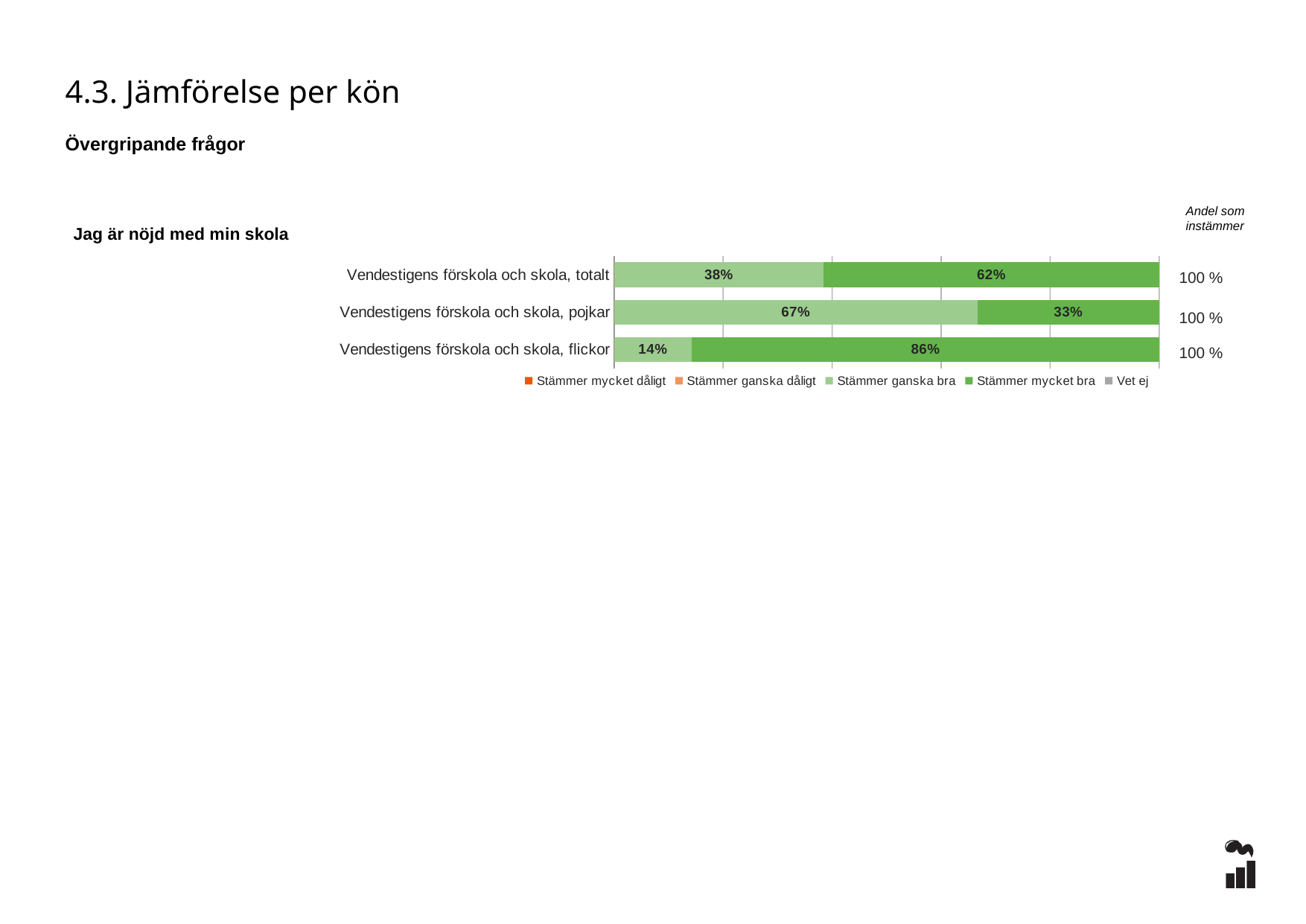
How many series does the legend list? 5 What is the difference between the "Stämmer mycket bra" values for flickor and pojkar? 53% Which category has the lowest value for "Stämmer ganska bra"? Vendestigens förskola och skola, flickor What is the value of "Stämmer mycket bra" for Vendestigens förskola och skola, totalt? 62% What is the value of "Stämmer mycket bra" for Vendestigens förskola och skola, flickor? 86% What is the value of "Stämmer ganska bra" for Vendestigens förskola och skola, pojkar? 67% What is the statement shown as the chart's title? Jag är nöjd med min skola What is the total of the stacked bar for Vendestigens förskola och skola, pojkar? 100 % How many categories (bars) are shown in the chart? 3 Which category has the highest value for "Stämmer mycket bra"? Vendestigens förskola och skola, flickor What kind of chart is shown on the slide? Stacked bar chart Which is larger: "Stämmer ganska bra" for pojkar or "Stämmer ganska bra" for totalt? Pojkar